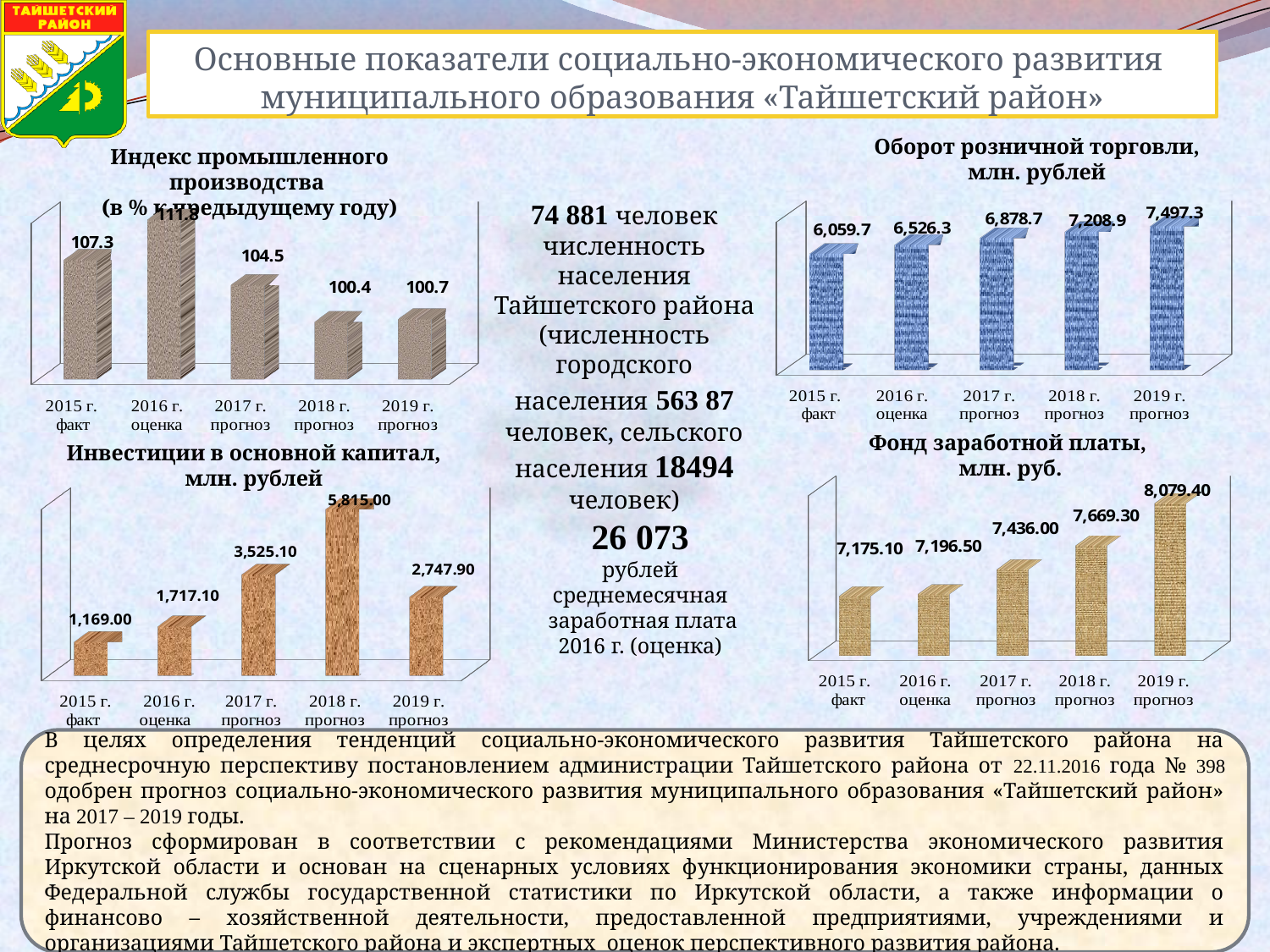
On the chart 'Индекс промышленного производства', what is the difference between the 2015 г. факт value and the 2017 г. прогноз value? 2.8 On the chart 'Индекс промышленного производства', what is the value for 2016 г. оценка? 111.8 On the chart 'Инвестиции в основной капитал, млн. рублей', what is the value for 2018 г. прогноз? 5,815.00 On the chart 'Фонд заработной платы, млн. руб.', what is the difference between the 2019 г. прогноз value and the 2018 г. прогноз value? 410.10 On the chart 'Индекс промышленного производства', which year has the lowest value? 2018 г. прогноз On the chart 'Оборот розничной торговли, млн. рублей', do the values rise or fall from 2015 to 2019? rise On the chart 'Оборот розничной торговли, млн. рублей', how many years are shown? 5 On the chart 'Инвестиции в основной капитал, млн. рублей', which year has the highest value? 2018 г. прогноз What kind of chart is 'Фонд заработной платы, млн. руб.'? bar chart On the chart 'Инвестиции в основной капитал, млн. рублей', which is larger: the value for 2017 г. прогноз or the value for 2019 г. прогноз? 2017 г. прогноз On the chart 'Оборот розничной торговли, млн. рублей', what is the value for 2015 г. факт? 6,059.7 On the chart 'Фонд заработной платы, млн. руб.', what is the value for 2019 г. прогноз? 8,079.40